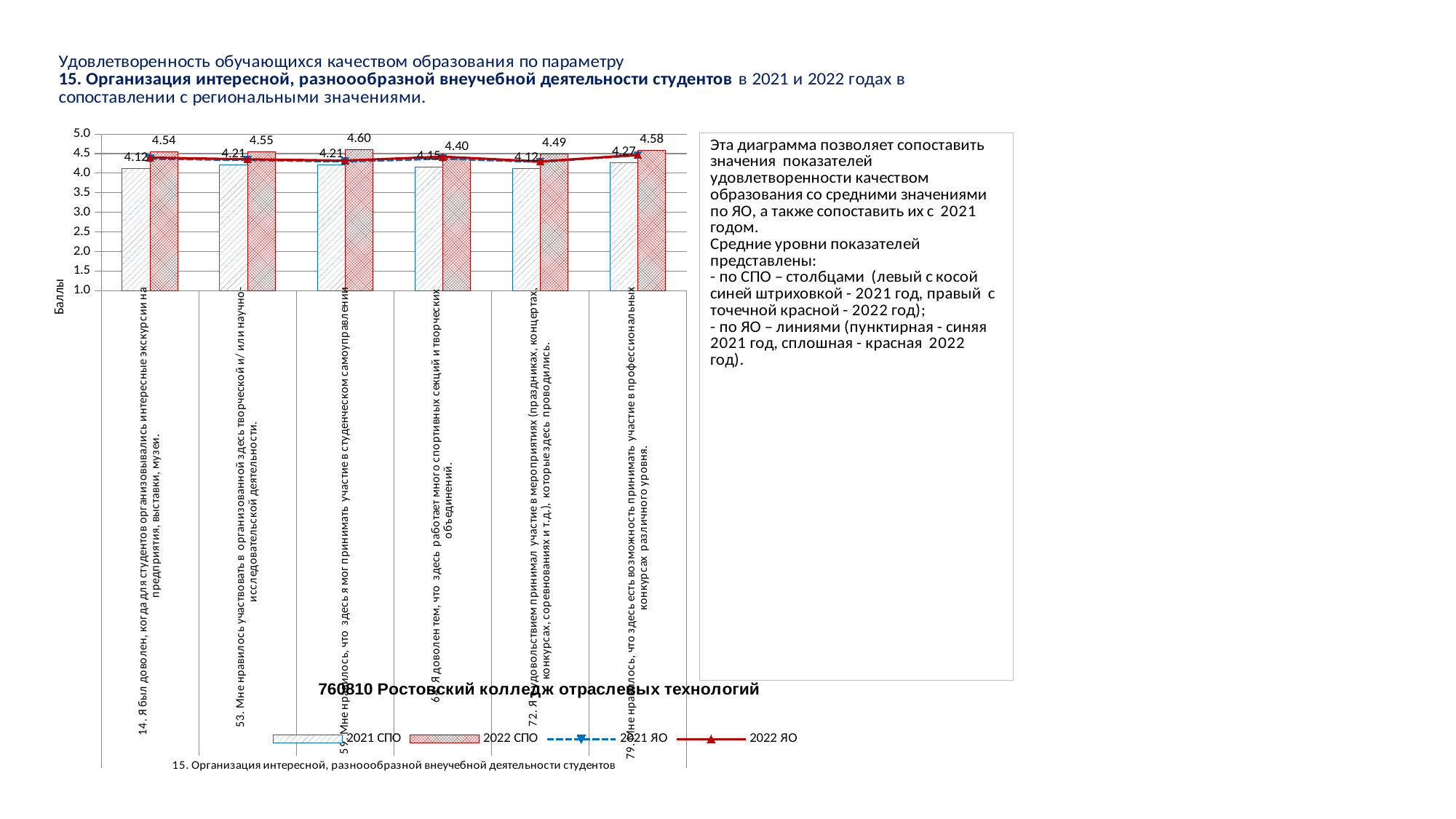
What is the 2022 СПО value for category 14 (Я был доволен, когда для студентов организовывались интересные экскурсии...)? 4.54 Which category has the highest 2021 СПО value? 79. Мне нравилось, что здесь есть возможность принимать участие в профессиональных конкурсах различного уровня How many series does the chart legend list? 4 How many categories are shown on the x axis of the chart? 6 For category 72, which is larger: the 2021 СПО value or the 2022 СПО value? 2022 СПО What is the 2021 СПО value for category 79 (Мне нравилось, что здесь есть возможность принимать участие в профессиональных конкурсах...)? 4.27 Which category has the lowest 2022 СПО value? 64. Я доволен тем, что здесь работает много спортивных секций и творческих объединений Is the 2021 СПО value for category 53 greater or less than 4.5? less Which category has the highest 2022 СПО value? 59. Мне нравилось, что здесь я мог принимать участие в студенческом самоуправлении What kind of chart is shown on the slide? Combined bar and line chart What is the difference between the 2022 СПО and 2021 СПО values for category 59? 0.39